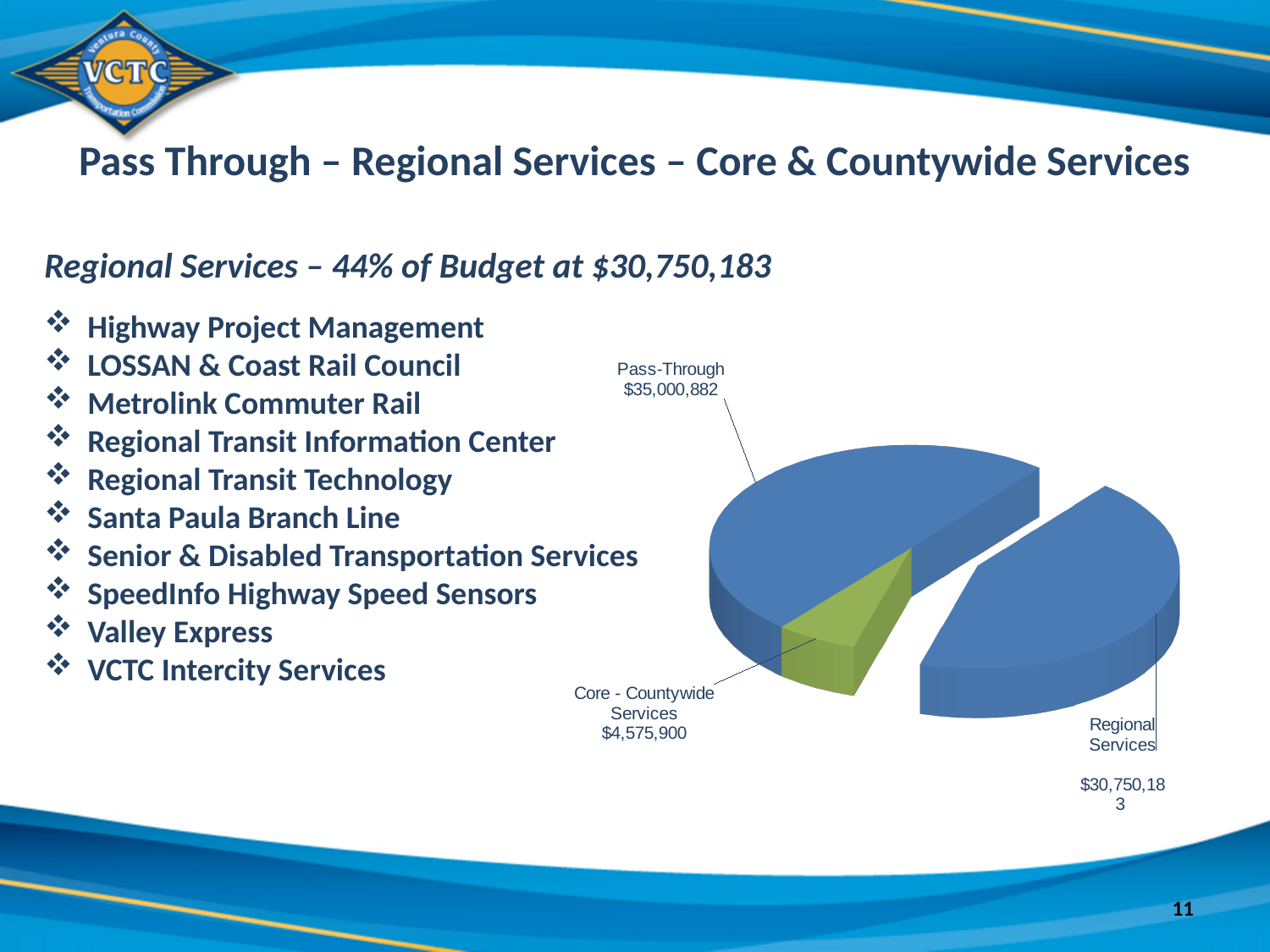
Which is larger, Pass-Through or Regional Services? Pass-Through What kind of chart is shown on the slide? Pie chart Which slice of the pie chart is shown in green? Core - Countywide Services What is the difference between the Regional Services and Core - Countywide Services values? $26,174,283 Which slice of the pie chart is the largest? Pass-Through Which slice of the pie chart is the smallest? Core - Countywide Services How many slices does the pie chart have? 3 What is the value of the Core - Countywide Services slice? $4,575,900 What is the value of the Regional Services slice? $30,750,183 What is the value of the Pass-Through slice? $35,000,882 What is the difference between the Pass-Through and Regional Services values? $4,250,699 What share of the budget does Regional Services represent, according to the slide? 44%